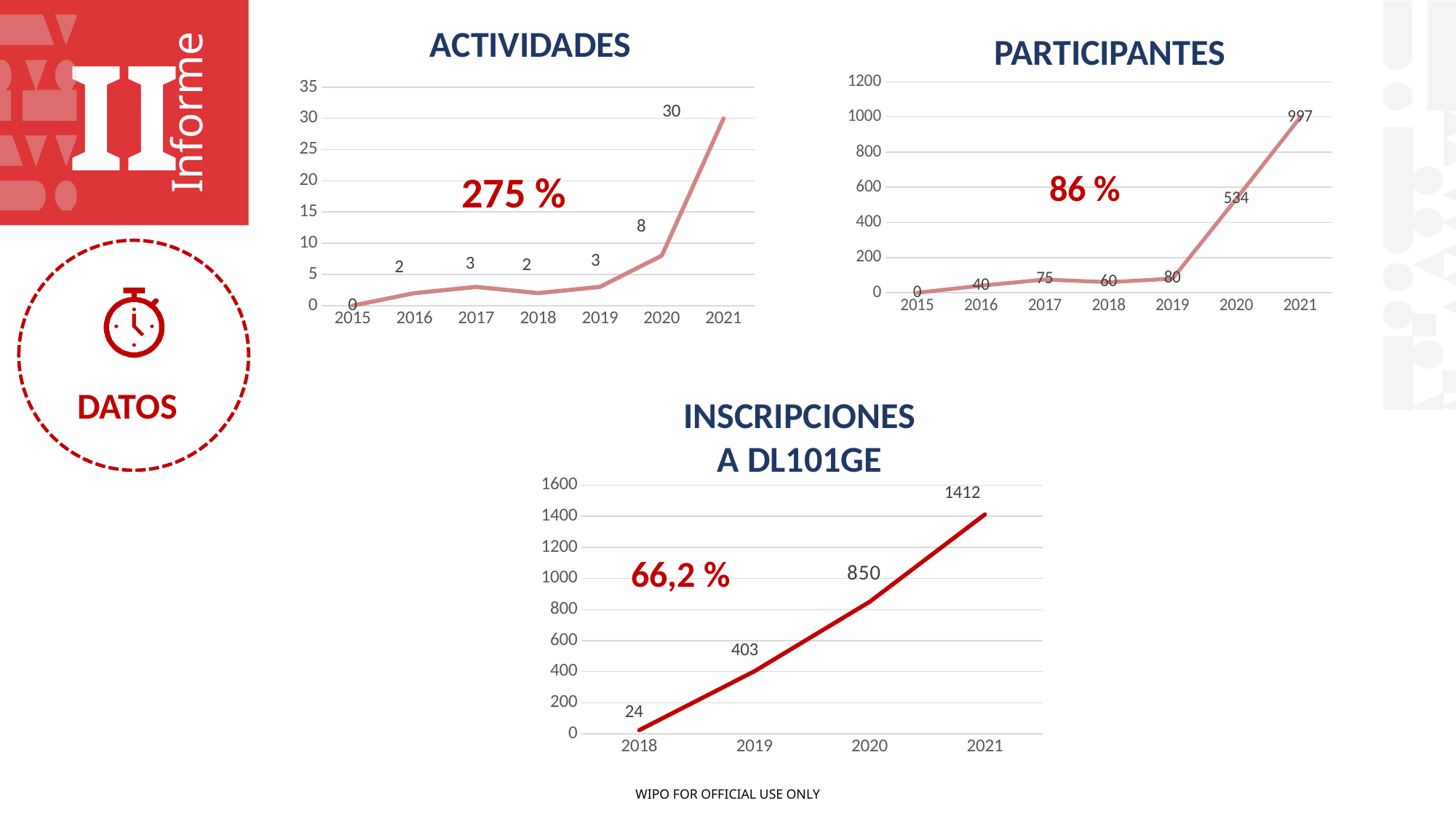
How many years are plotted in the PARTICIPANTES chart? 7 What kind of chart is the INSCRIPCIONES A DL101GE chart? line chart In the INSCRIPCIONES A DL101GE chart, do the values rise or fall from 2018 to 2021? rise In the ACTIVIDADES chart, what is the difference between the values for 2021 and 2020? 22 In the ACTIVIDADES chart, what is the value for 2020? 8 In the INSCRIPCIONES A DL101GE chart, what is the difference between the values for 2021 and 2020? 562 In the PARTICIPANTES chart, what is the value for 2020? 534 In the PARTICIPANTES chart, which year has the highest value? 2021 In the INSCRIPCIONES A DL101GE chart, what is the value for 2019? 403 In the ACTIVIDADES chart, what is the value for 2021? 30 In the PARTICIPANTES chart, which is larger, the value for 2017 or the value for 2018? 2017 In the ACTIVIDADES chart, which year has the lowest value? 2015